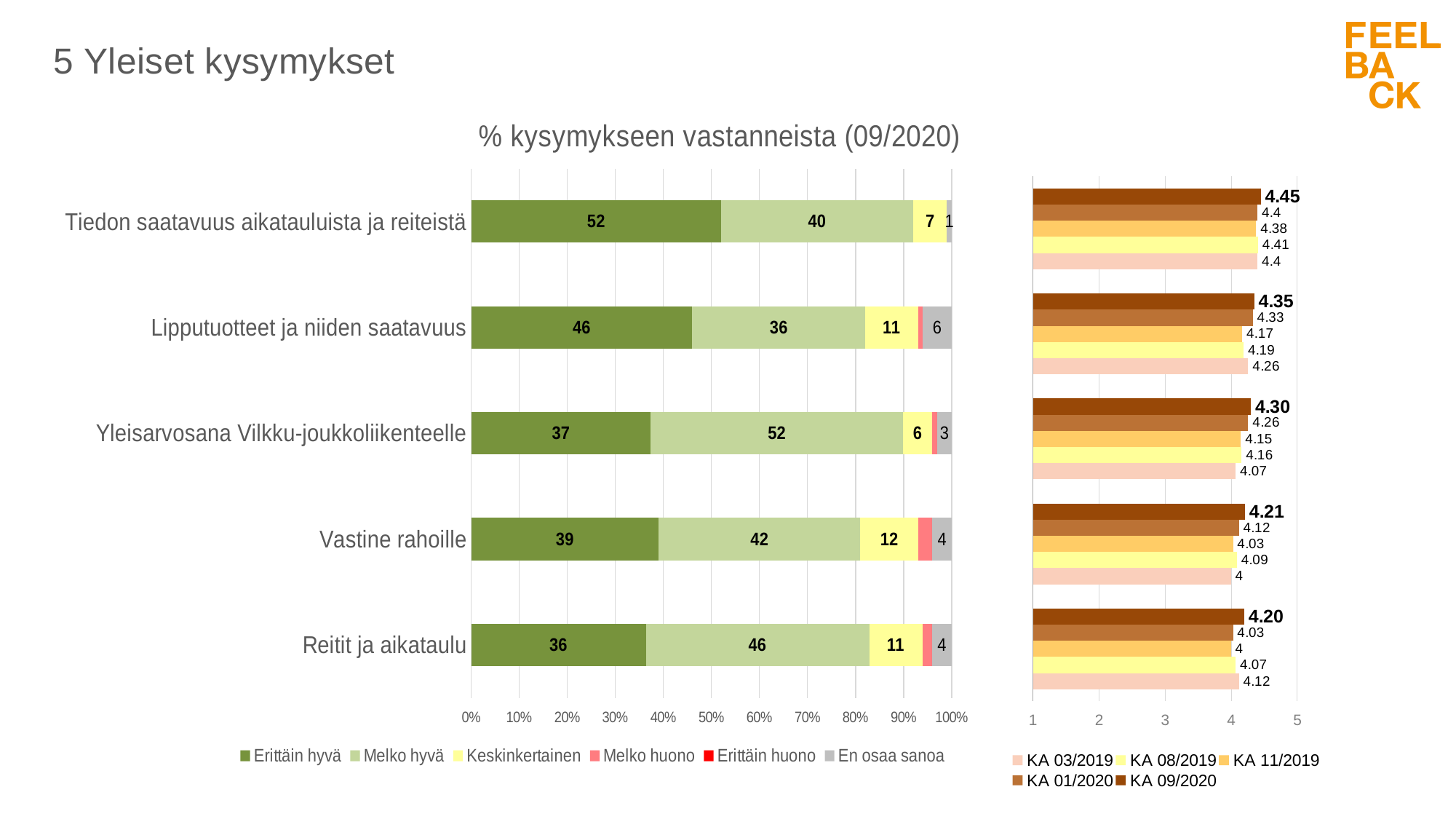
In the left chart '% kysymykseen vastanneista (09/2020)', which category has the lowest Erittäin hyvä value? Reitit ja aikataulu How many categories are shown in the left chart '% kysymykseen vastanneista (09/2020)'? 5 How many series does the legend of the left chart '% kysymykseen vastanneista (09/2020)' list? 6 In the left chart '% kysymykseen vastanneista (09/2020)', what is the Erittäin hyvä value for 'Tiedon saatavuus aikatauluista ja reiteistä'? 52 What kind of chart is the left chart '% kysymykseen vastanneista (09/2020)'? Stacked bar chart In the right chart (KA averages), what is the KA 09/2020 value for 'Tiedon saatavuus aikatauluista ja reiteistä'? 4.45 In the left chart '% kysymykseen vastanneista (09/2020)', what is the difference between the Erittäin hyvä values for 'Tiedon saatavuus aikatauluista ja reiteistä' and 'Lipputuotteet ja niiden saatavuus'? 6 In the left chart '% kysymykseen vastanneista (09/2020)', which category has the highest Erittäin hyvä value? Tiedon saatavuus aikatauluista ja reiteistä How many series does the legend of the right chart (KA averages) list? 5 In the right chart (KA averages), what is the KA 03/2019 value for 'Reitit ja aikataulu'? 4.12 In the left chart '% kysymykseen vastanneista (09/2020)', what is the Melko hyvä value for 'Yleisarvosana Vilkku-joukkoliikenteelle'? 52 In the right chart (KA averages), which is larger for KA 09/2020: 'Lipputuotteet ja niiden saatavuus' or 'Yleisarvosana Vilkku-joukkoliikenteelle'? Lipputuotteet ja niiden saatavuus